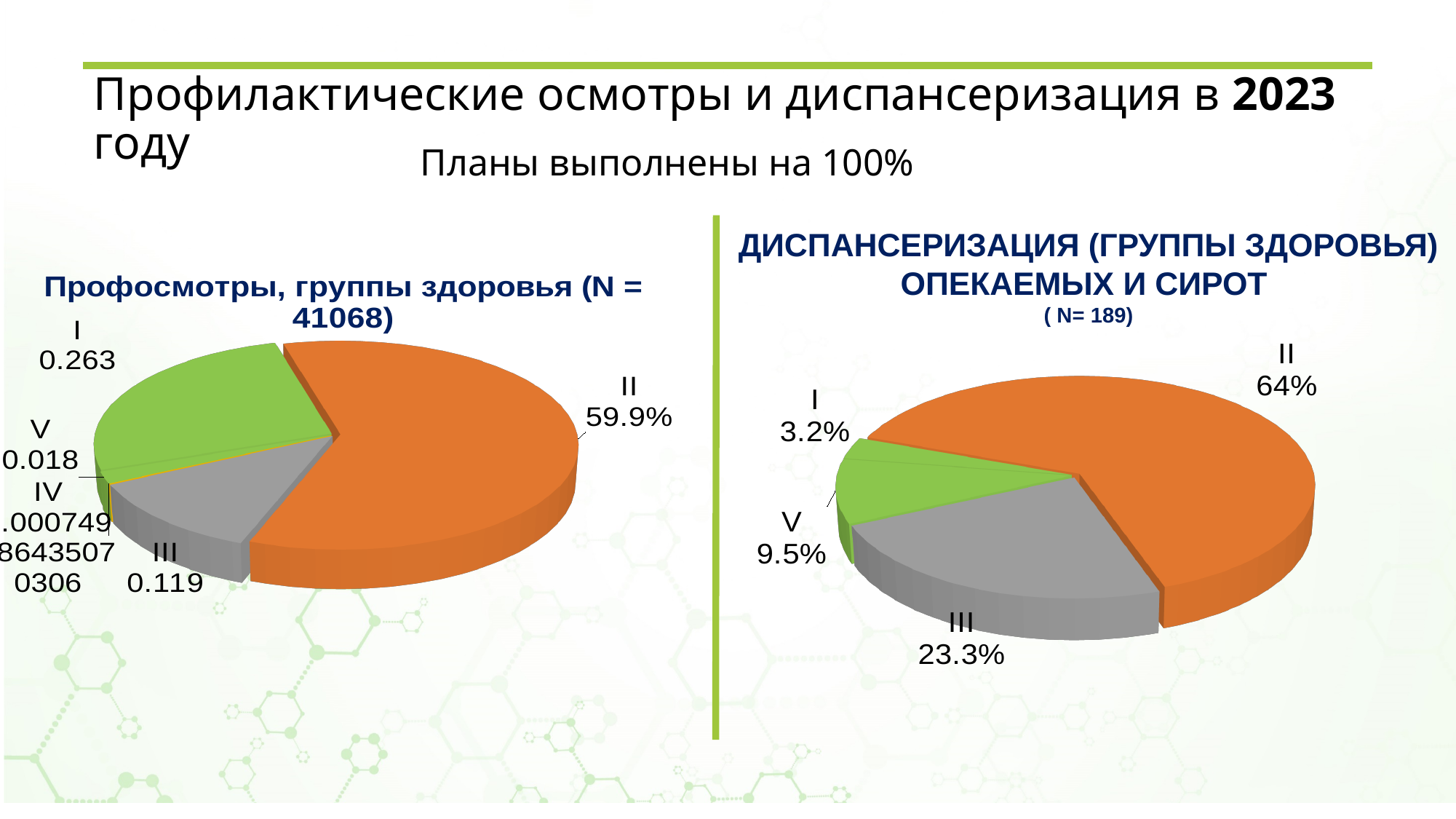
In the right chart (Диспансеризация опекаемых и сирот), what share does group II have? 64% In the right chart (Диспансеризация опекаемых и сирот), which is larger: group III or group V? III In the left chart (Профосмотры, группы здоровья), what value is shown for group III? 0.119 In the left chart (Профосмотры, группы здоровья), what value is shown for group I? 0.263 In the right chart (Диспансеризация опекаемых и сирот), which group has the smallest slice? I What type of chart is used on the right side of the slide? Pie chart In the left chart (Профосмотры, группы здоровья), what value is shown for group V? 0.018 In the left chart (Профосмотры, группы здоровья), what value is shown for group II? 59.9% In the right chart (Диспансеризация опекаемых и сирот), what share does group V have? 9.5% In the right chart (Диспансеризация опекаемых и сирот), what share does group III have? 23.3% What is the N value stated in the title of the right chart? 189 In the left chart (Профосмотры, группы здоровья), which group has the largest slice? II